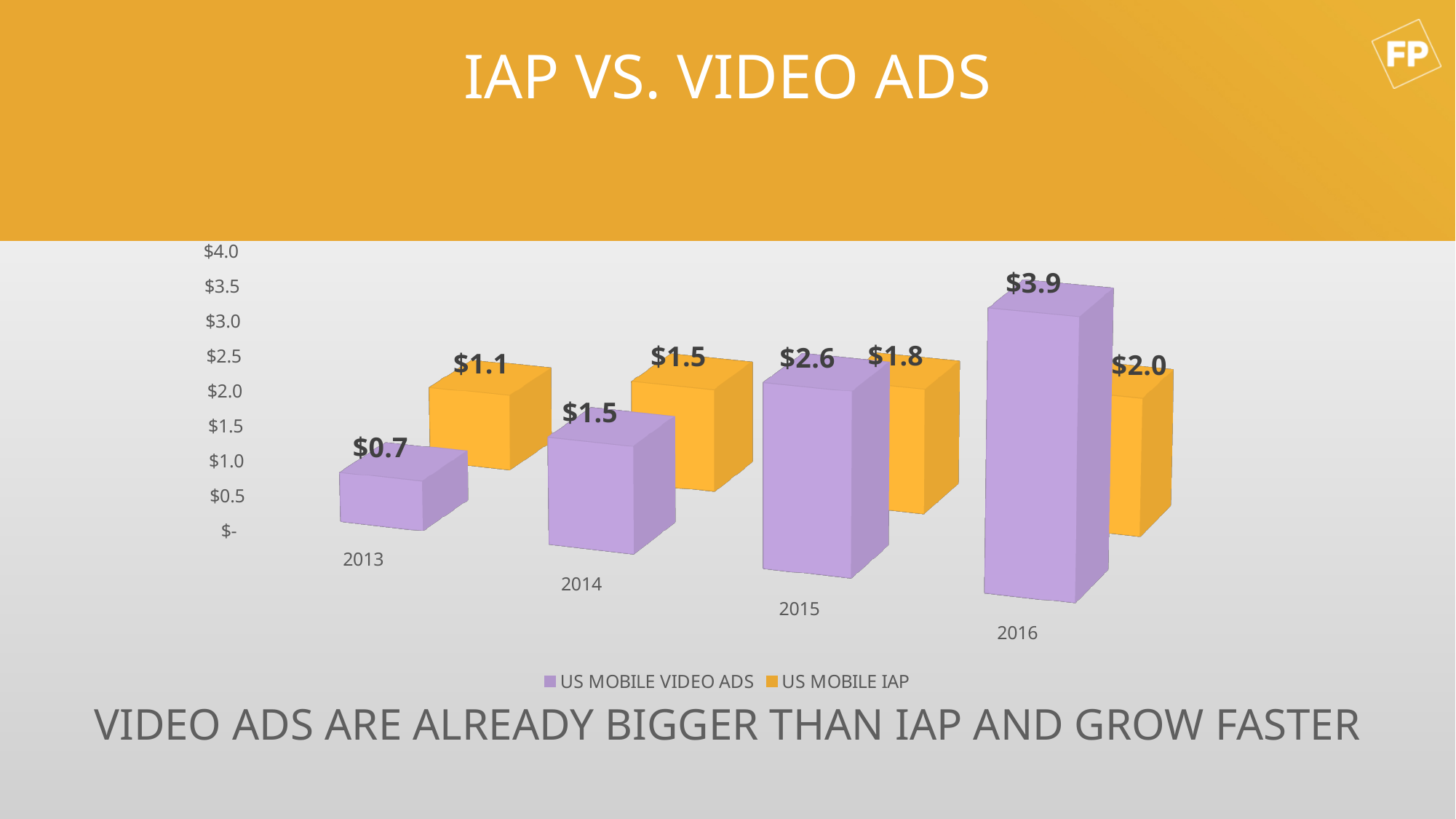
In which year is US MOBILE IAP lowest? 2013 Do the US MOBILE VIDEO ADS values rise or fall from 2013 to 2016? Rise What kind of chart is shown on the slide? Bar chart What is the value for US MOBILE VIDEO ADS in 2016? $3.9 What is the value for US MOBILE IAP in 2014? $1.5 In which year is US MOBILE VIDEO ADS highest? 2016 What is the value for US MOBILE VIDEO ADS in 2013? $0.7 What is the value for US MOBILE IAP in 2016? $2.0 How many series does the legend list? 2 Which is larger in 2015, US MOBILE VIDEO ADS or US MOBILE IAP? US MOBILE VIDEO ADS How many years are shown on the x axis? 4 What is the difference between US MOBILE VIDEO ADS and US MOBILE IAP in 2016? $1.9